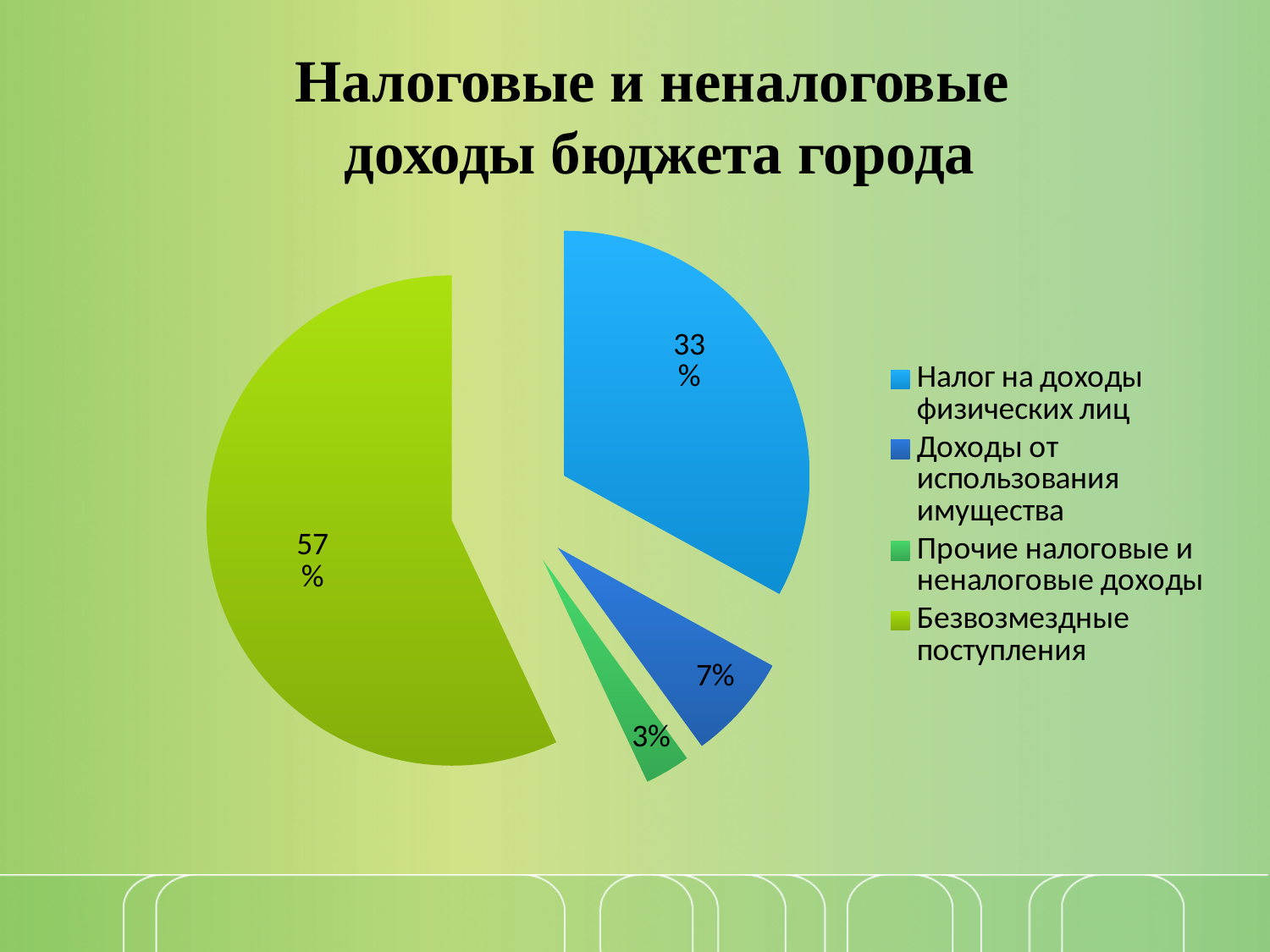
What share of the pie does "Безвозмездные поступления" have? 57% Which category has the largest slice of the pie? Безвозмездные поступления What is the title of the slide containing the chart? Налоговые и неналоговые доходы бюджета города What is the difference in percentage points between "Безвозмездные поступления" and "Налог на доходы физических лиц"? 24 percentage points What share of the pie does "Прочие налоговые и неналоговые доходы" have? 3% What share of the pie does "Доходы от использования имущества" have? 7% What kind of chart is shown on the slide? Pie chart Which category has the smallest slice of the pie? Прочие налоговые и неналоговые доходы How many slices does the pie chart have? 4 Which is larger: "Доходы от использования имущества" or "Прочие налоговые и неналоговые доходы"? Доходы от использования имущества How many entries does the legend list? 4